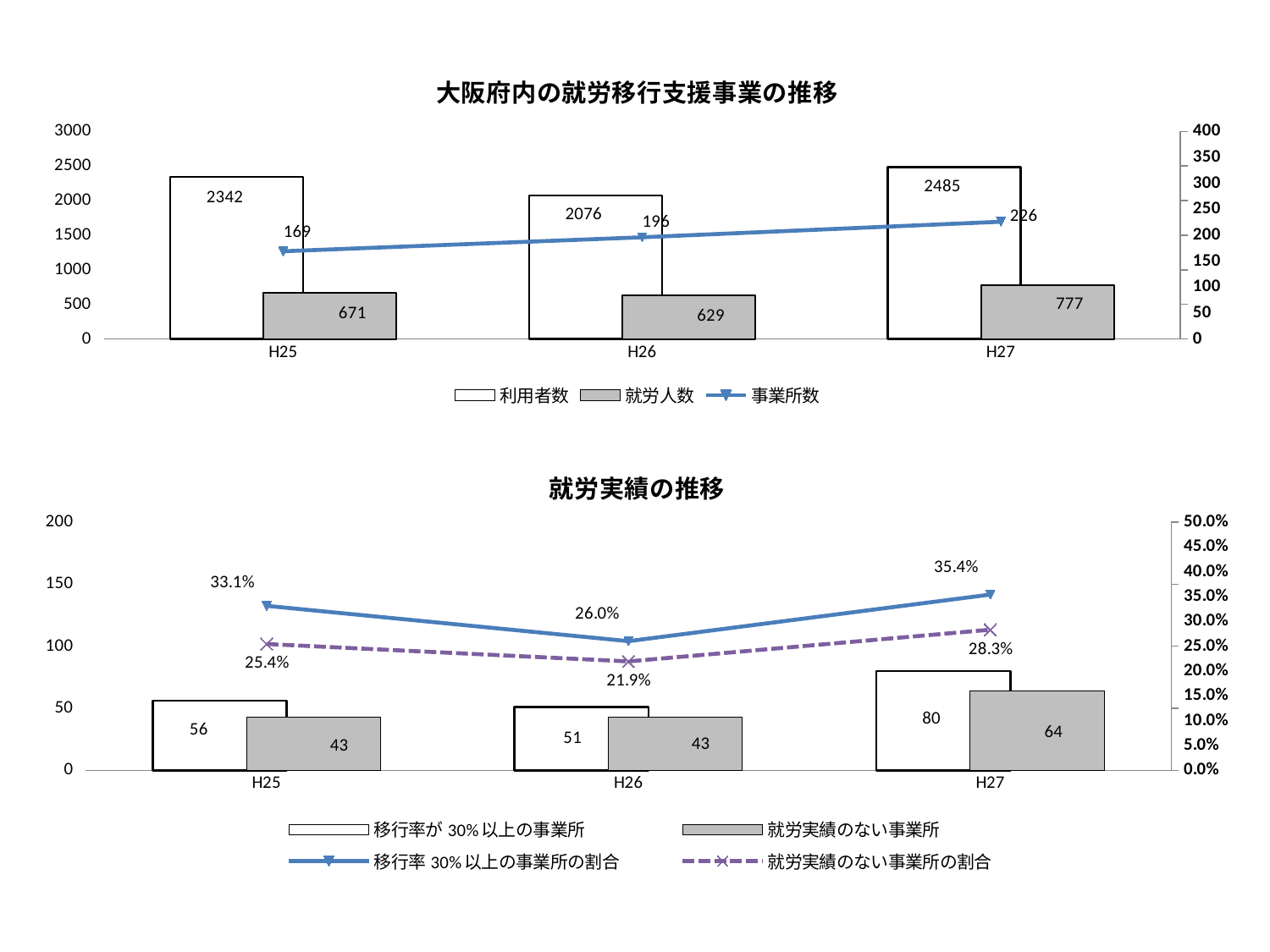
In the top chart titled 大阪府内の就労移行支援事業の推移, what is the value of 就労人数 for H26? 629 In the top chart titled 大阪府内の就労移行支援事業の推移, does 事業所数 rise or fall from H25 to H27? rise In the bottom chart titled 就労実績の推移, in which year is 移行率30%以上の事業所の割合 highest? H27 In the bottom chart titled 就労実績の推移, what is the 就労実績のない事業所の割合 for H26? 21.9% In the top chart titled 大阪府内の就労移行支援事業の推移, in which year is 利用者数 lowest? H26 In the top chart titled 大阪府内の就労移行支援事業の推移, what is the value of 事業所数 for H25? 169 In the bottom chart titled 就労実績の推移, what is the value of 移行率が30%以上の事業所 for H27? 80 In the top chart titled 大阪府内の就労移行支援事業の推移, what is the value of 利用者数 for H27? 2485 In the bottom chart titled 就労実績の推移, which is larger for H25: 移行率が30%以上の事業所 or 就労実績のない事業所? 移行率が30%以上の事業所 In the top chart titled 大阪府内の就労移行支援事業の推移, what is the difference in 就労人数 between H27 and H26? 148 In the top chart titled 大阪府内の就労移行支援事業の推移, how many series does the legend list? 3 In the bottom chart titled 就労実績の推移, how many years are shown on the x axis? 3